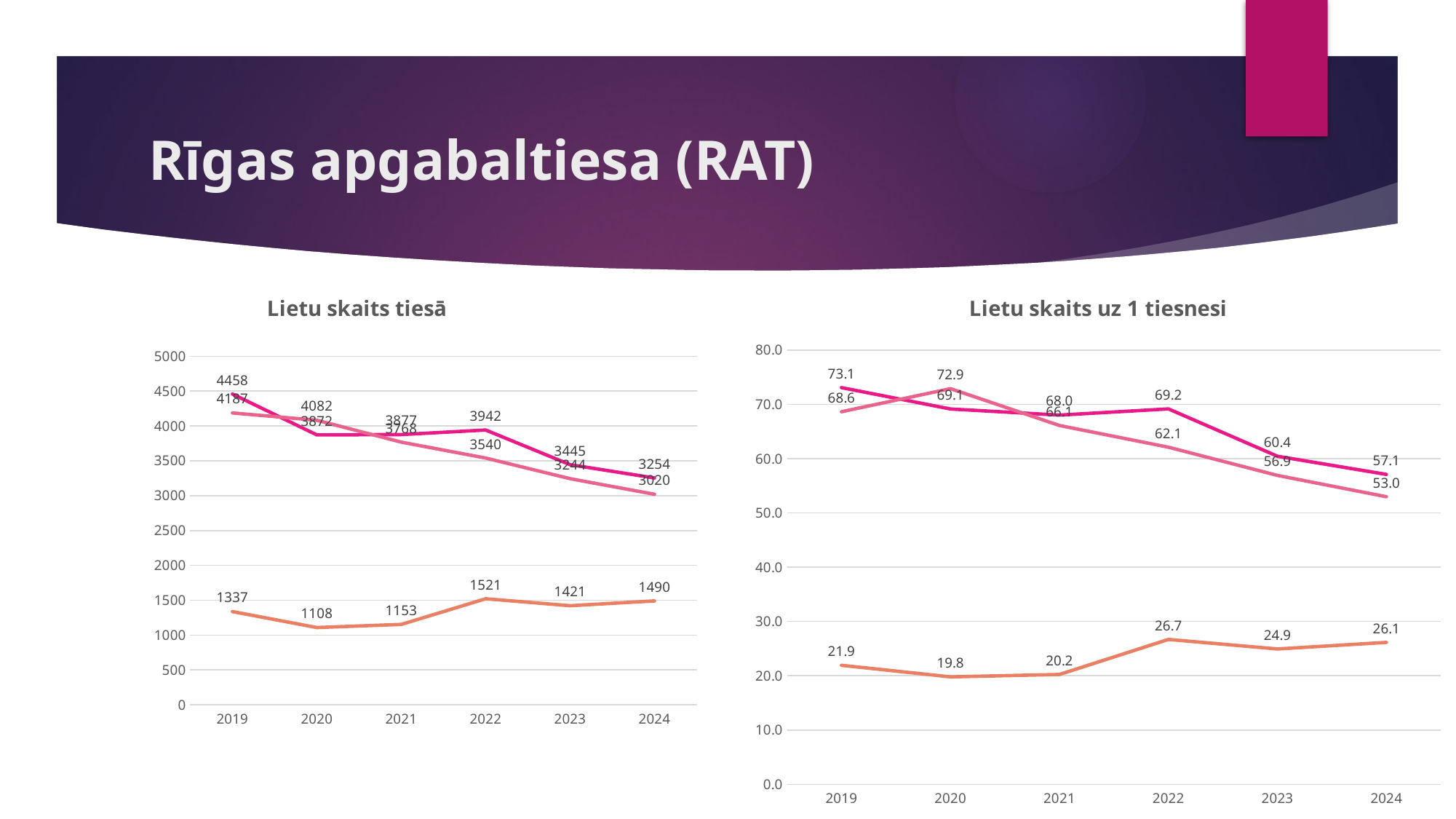
What kind of chart is "Lietu skaits tiesā"? line chart In the "Lietu skaits uz 1 tiesnesi" chart, is the orange line's value in 2022 greater or less than 30.0? less In the "Lietu skaits tiesā" chart, in which year does the orange (lowest) line have its lowest value? 2020 In the "Lietu skaits tiesā" chart, what is the value of the orange (lowest) line in 2022? 1521 In the "Lietu skaits tiesā" chart, in which year does the orange (lowest) line reach its highest value? 2022 How many years are shown on the x axis of the "Lietu skaits uz 1 tiesnesi" chart? 6 In the "Lietu skaits tiesā" chart, is the orange line's value in 2019 greater or less than 1000? greater In the "Lietu skaits uz 1 tiesnesi" chart, what is the highest value of the orange (lowest) line? 26.7 In the "Lietu skaits uz 1 tiesnesi" chart, is the orange line's value higher in 2022 or in 2020? 2022 In the "Lietu skaits tiesā" chart, what is the difference between the orange line's values in 2024 and 2023? 69 In the "Lietu skaits uz 1 tiesnesi" chart, what is the value of the orange (lowest) line in 2019? 21.9 What is the title of the chart on the right side of the slide? Lietu skaits uz 1 tiesnesi